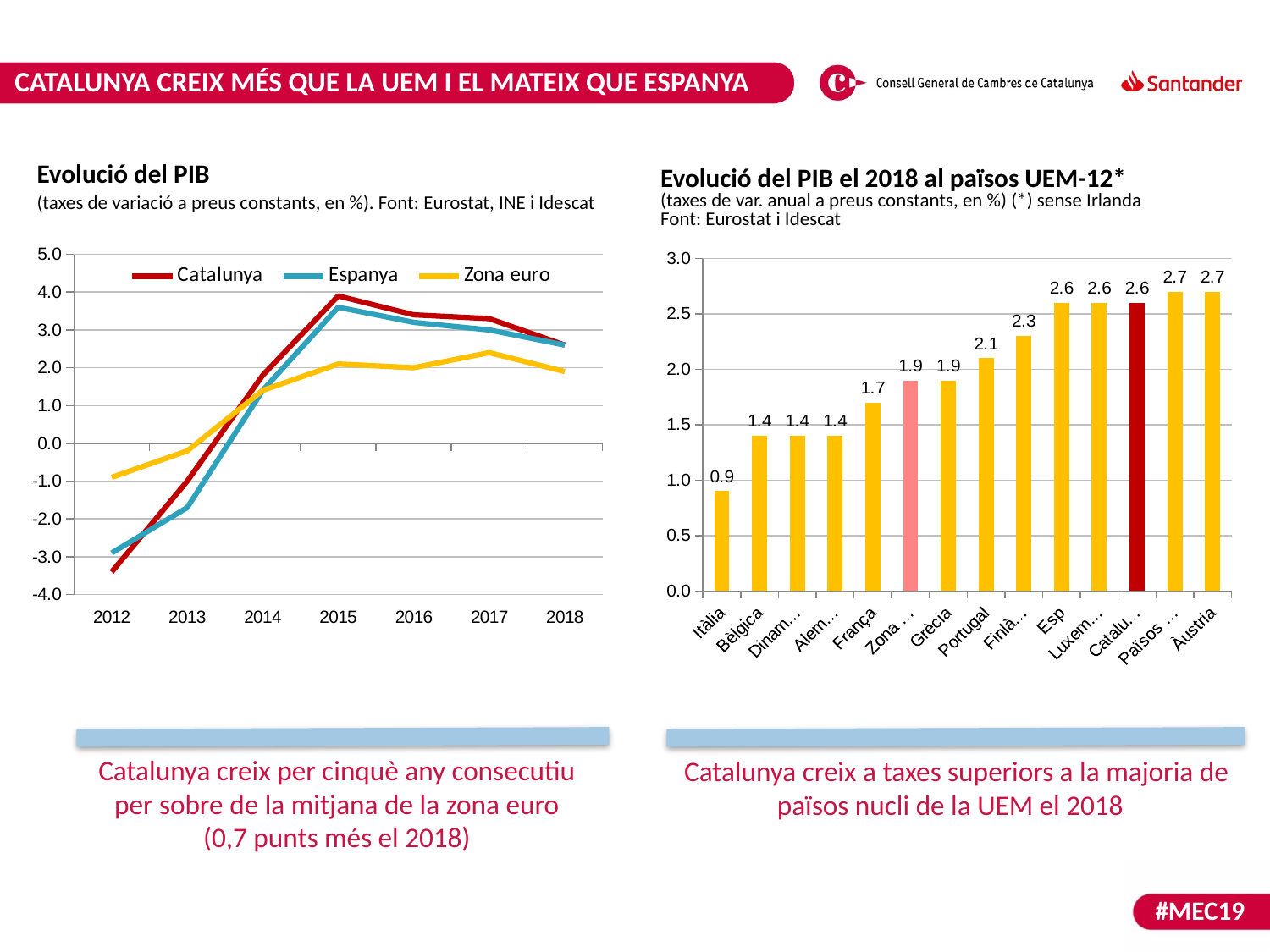
In the right chart 'Evolució del PIB el 2018 al països UEM-12*', what is the value for Itàlia? 0.9 What kind of chart is the right chart titled 'Evolució del PIB el 2018 al països UEM-12*'? bar chart In the right chart 'Evolució del PIB el 2018 al països UEM-12*', which is larger, the value for Grècia or the value for Bèlgica? Grècia In the left chart 'Evolució del PIB', is the value for Catalunya in 2012 greater or less than -3.0? less How many series does the legend of the left chart 'Evolució del PIB' list? 3 How many years are shown on the x axis of the left chart 'Evolució del PIB'? 7 In the left chart 'Evolució del PIB', is the value for Catalunya in 2015 greater or less than 3.0? greater What kind of chart is the left chart titled 'Evolució del PIB'? line chart In the right chart 'Evolució del PIB el 2018 al països UEM-12*', what is the value for Portugal? 2.1 In the left chart 'Evolució del PIB', does the Catalunya line rise or fall from 2012 to 2015? rise In the right chart 'Evolució del PIB el 2018 al països UEM-12*', what is the difference between the values for Àustria and França? 1.0 In the right chart 'Evolució del PIB el 2018 al països UEM-12*', which country has the lowest value? Itàlia